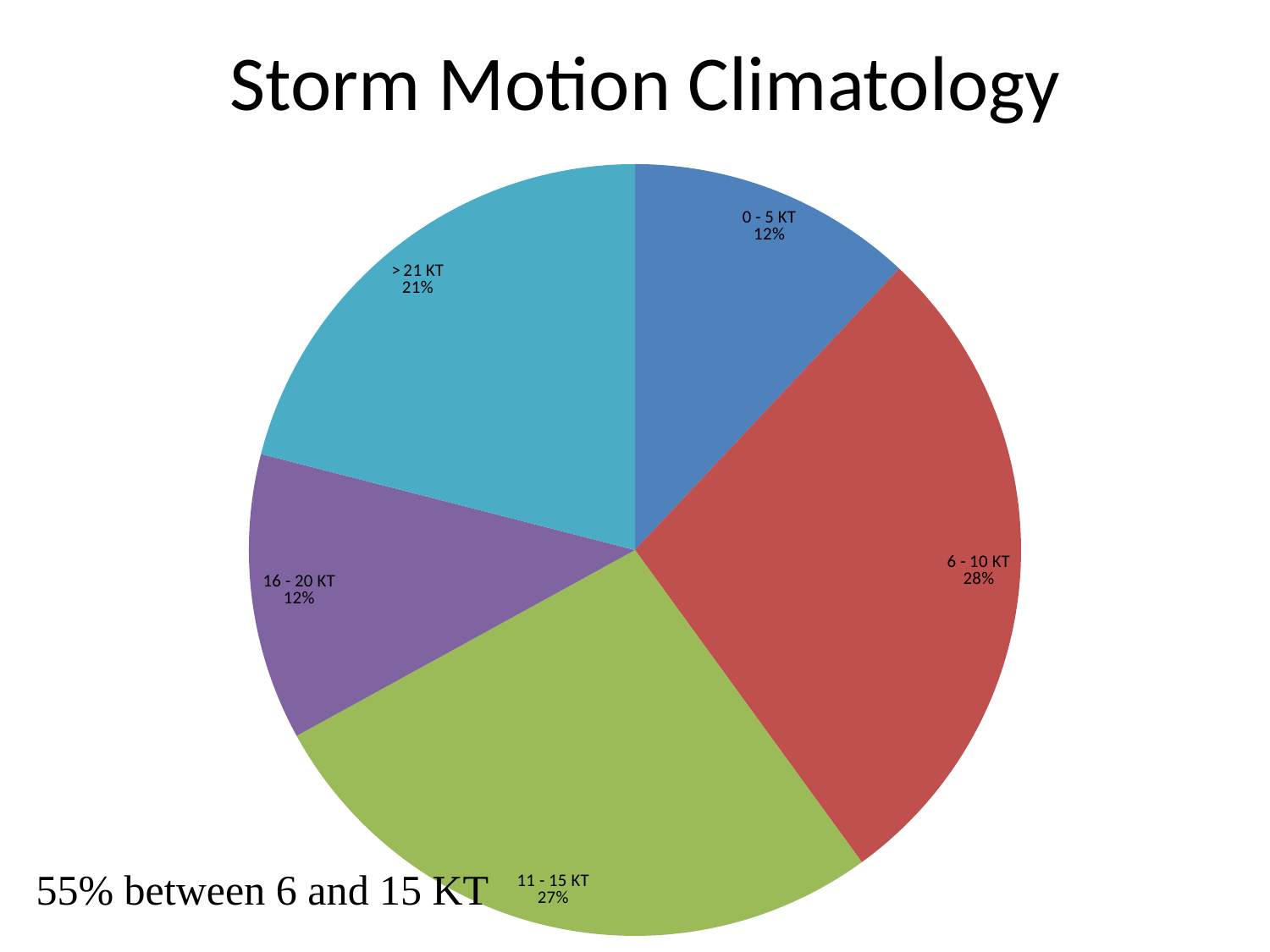
What is the title of the chart? Storm Motion Climatology Which category has the largest slice of the pie? 6 - 10 KT How many slices does the pie chart have? 5 What share of the pie does the 6 - 10 KT slice represent? 28% What is the value shown for the 0 - 5 KT slice? 12% What is the value shown for the 16 - 20 KT slice? 12% Which is larger, the 11 - 15 KT slice or the 16 - 20 KT slice? 11 - 15 KT What is the combined share of the 6 - 10 KT and 11 - 15 KT slices? 55% What share of the pie does the > 21 KT slice represent? 21% What share of the pie does the 11 - 15 KT slice represent? 27% What kind of chart is shown on the slide? Pie chart What is the difference between the 6 - 10 KT share and the > 21 KT share? 7%